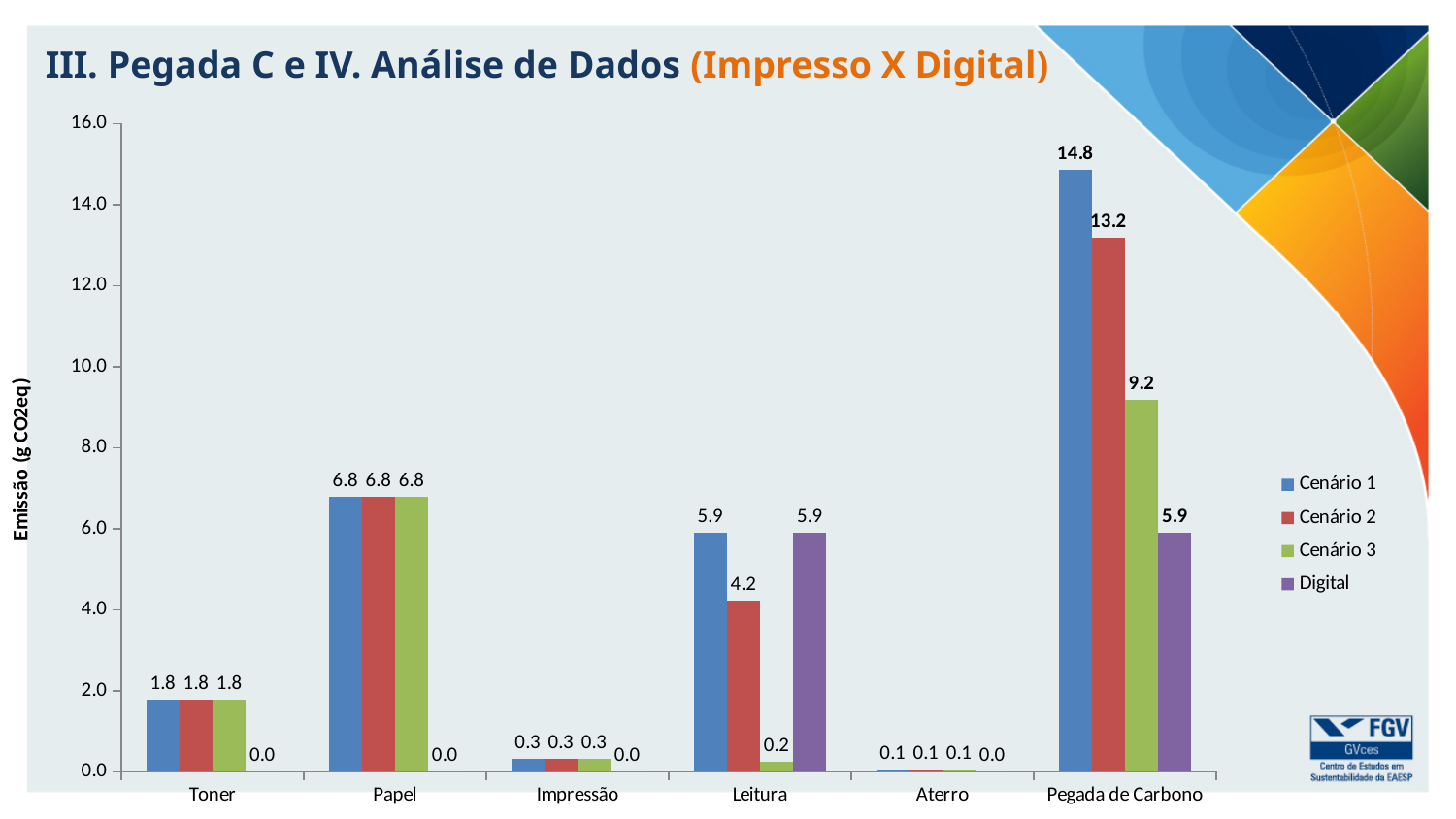
Which series has the highest value in the Pegada de Carbono category? Cenário 1 How many series does the legend list? 4 What kind of chart is shown on the slide? Bar chart What is the value for Cenário 1 in the Pegada de Carbono category? 14.8 What is the difference between Cenário 1 and Cenário 3 in the Pegada de Carbono category? 5.6 What is the label of the y axis? Emissão (g CO2eq) Which is larger in the Leitura category: Cenário 1 or Cenário 2? Cenário 1 How many categories are shown on the x axis? 6 What is the value for Cenário 2 in the Leitura category? 4.2 What is the value for Digital in the Pegada de Carbono category? 5.9 Which series has the lowest value in the Papel category? Digital What is the value for Cenário 3 in the Leitura category? 0.2